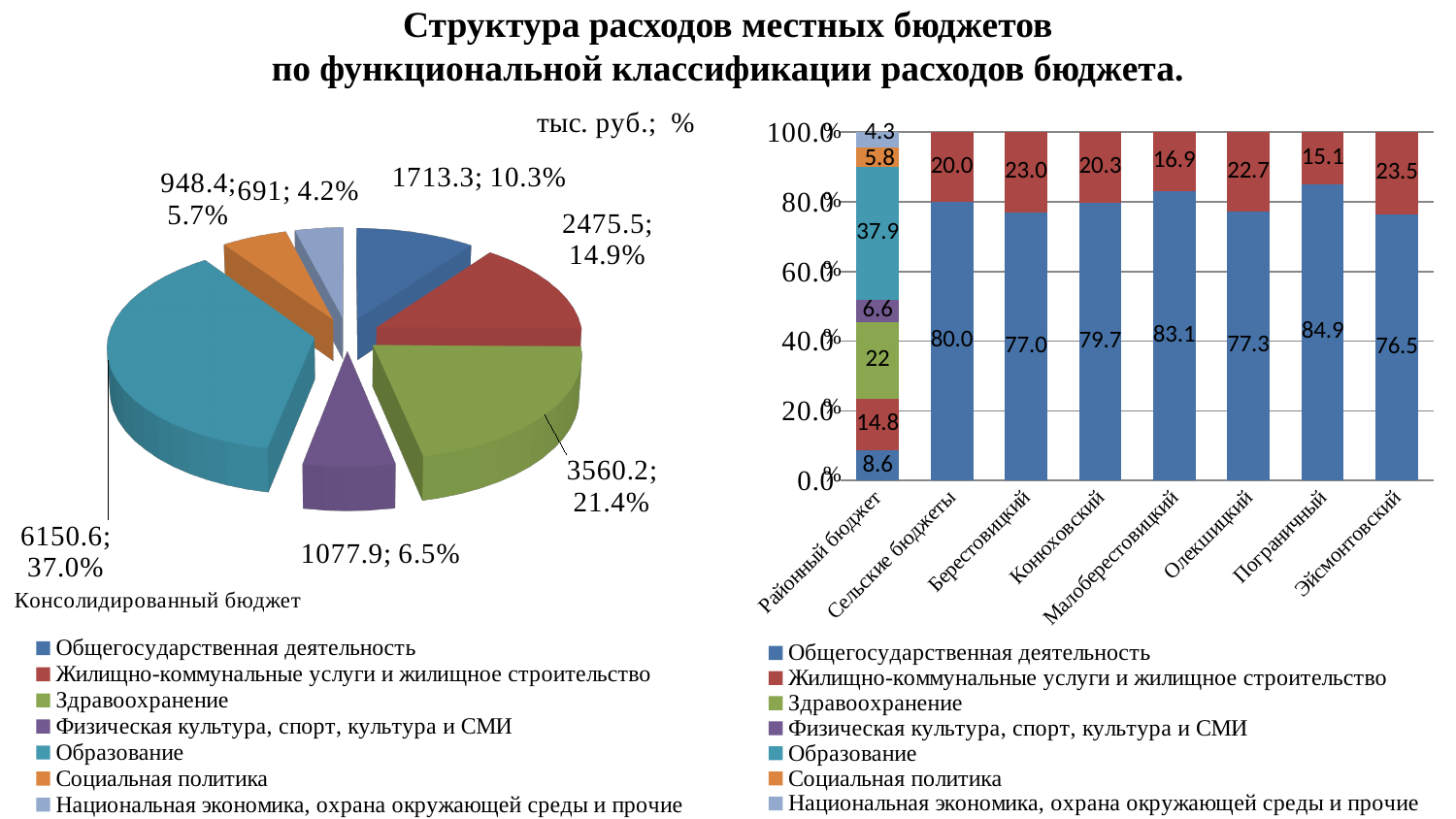
In the pie chart on the left, which category has the smallest slice? Национальная экономика, охрана окружающей среды и прочие In the pie chart on the left, how many slices are there? 7 In the pie chart on the left, which category has the largest slice? Образование In the stacked bar chart on the right, which is larger: the Общегосударственная деятельность value for Конюховский or for Олекшицкий? Конюховский What type of chart is shown on the right side of the slide? Stacked bar chart In the pie chart on the left, what is the difference in thousand rubles between Здравоохранение (3560.2) and Жилищно-коммунальные услуги и жилищное строительство (2475.5)? 1084.7 In the stacked bar chart on the right, what is the value of Образование for Районный бюджет? 37.9 In the pie chart on the left, what is the value shown for Образование? 6150.6; 37.0% In the stacked bar chart on the right, how many categories are shown on the x axis? 8 In the pie chart on the left, what percentage share does Здравоохранение have? 21.4% In the stacked bar chart on the right, which category has the highest value for Жилищно-коммунальные услуги и жилищное строительство? Эйсмонтовский In the stacked bar chart on the right, what is the value of Общегосударственная деятельность for Пограничный? 84.9